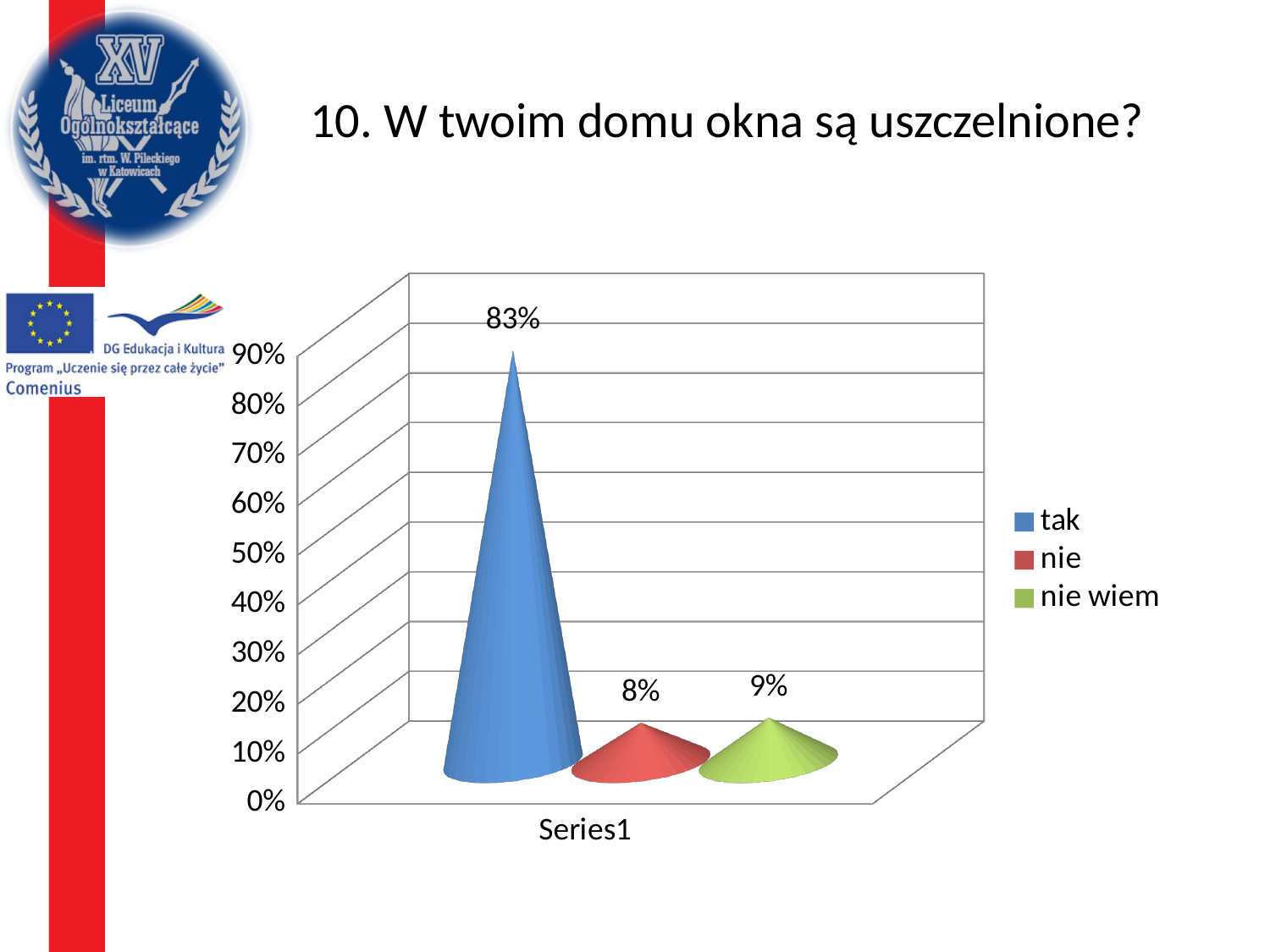
What is the value for "nie"? 8% Is the value for "tak" greater or less than 80%? greater What colour represents "tak" in the legend? Blue What is the value for "tak"? 83% Which answer has the lowest value? nie Which answer has the highest value? tak Which is larger, the value for "nie" or the value for "nie wiem"? nie wiem How many series does the legend list? 3 What is the difference between the values for "tak" and "nie"? 75 percentage points What is the title of the slide above the chart? 10. W twoim domu okna są uszczelnione? What is the difference between the values for "nie wiem" and "nie"? 1 percentage point What is the value for "nie wiem"? 9%